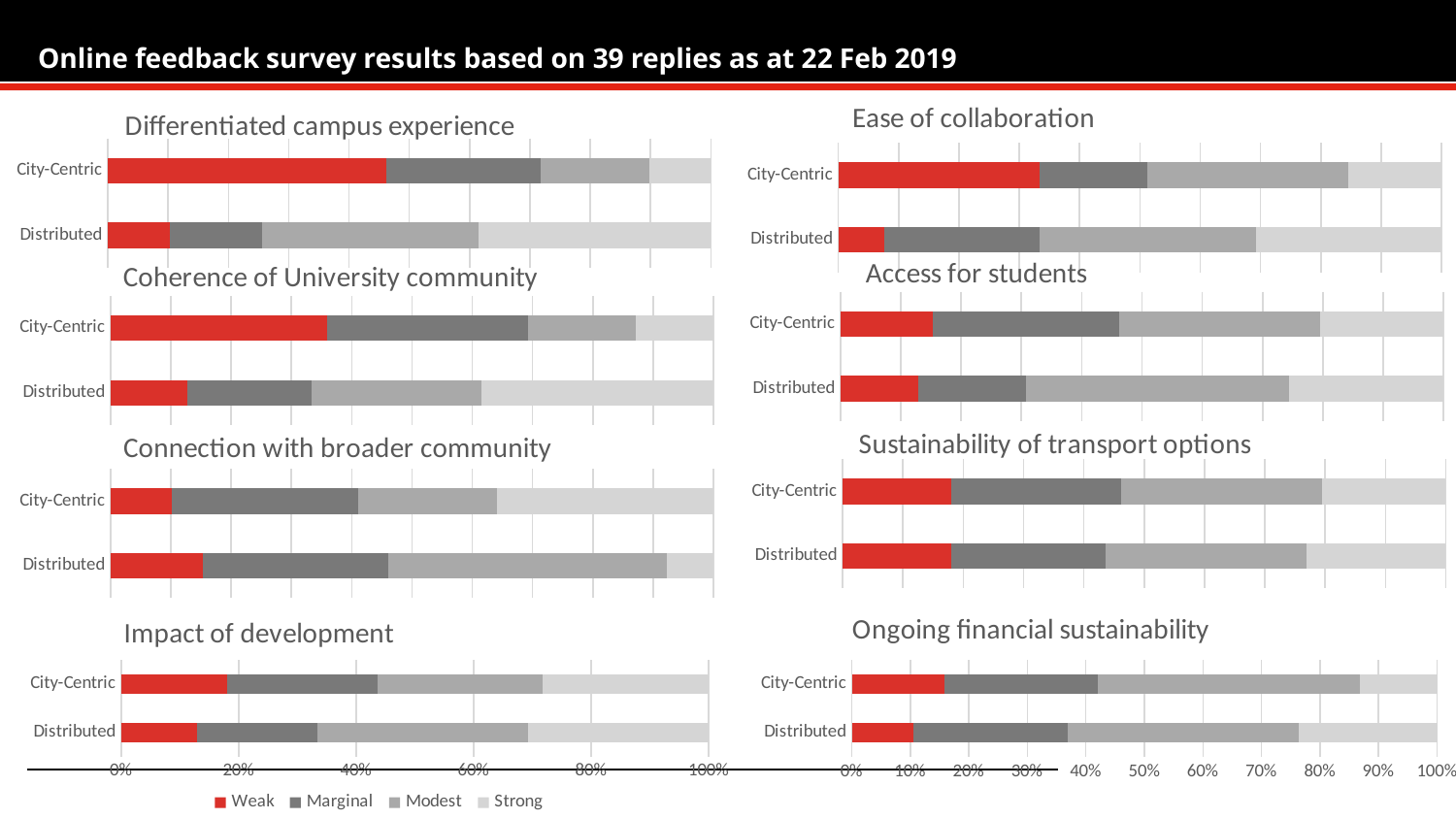
In the "Connection with broader community" chart, is the Weak segment for City-Centric greater or less than 20%? less In the "Ease of collaboration" chart, is the Weak segment for Distributed greater or less than 10%? less In the "Differentiated campus experience" chart, which category has the larger Weak segment, City-Centric or Distributed? City-Centric In the "Coherence of University community" chart, how many categories are plotted? 2 What kind of chart is used for "Differentiated campus experience"? Stacked bar chart In the "Differentiated campus experience" chart, is the Weak segment for City-Centric greater or less than 40%? greater What are the four series named in the legend? Weak, Marginal, Modest, Strong In the "Coherence of University community" chart, which category has the larger Weak segment, City-Centric or Distributed? City-Centric How many series does the legend at the bottom of the slide list? 4 How many replies does the slide title say the survey results are based on? 39